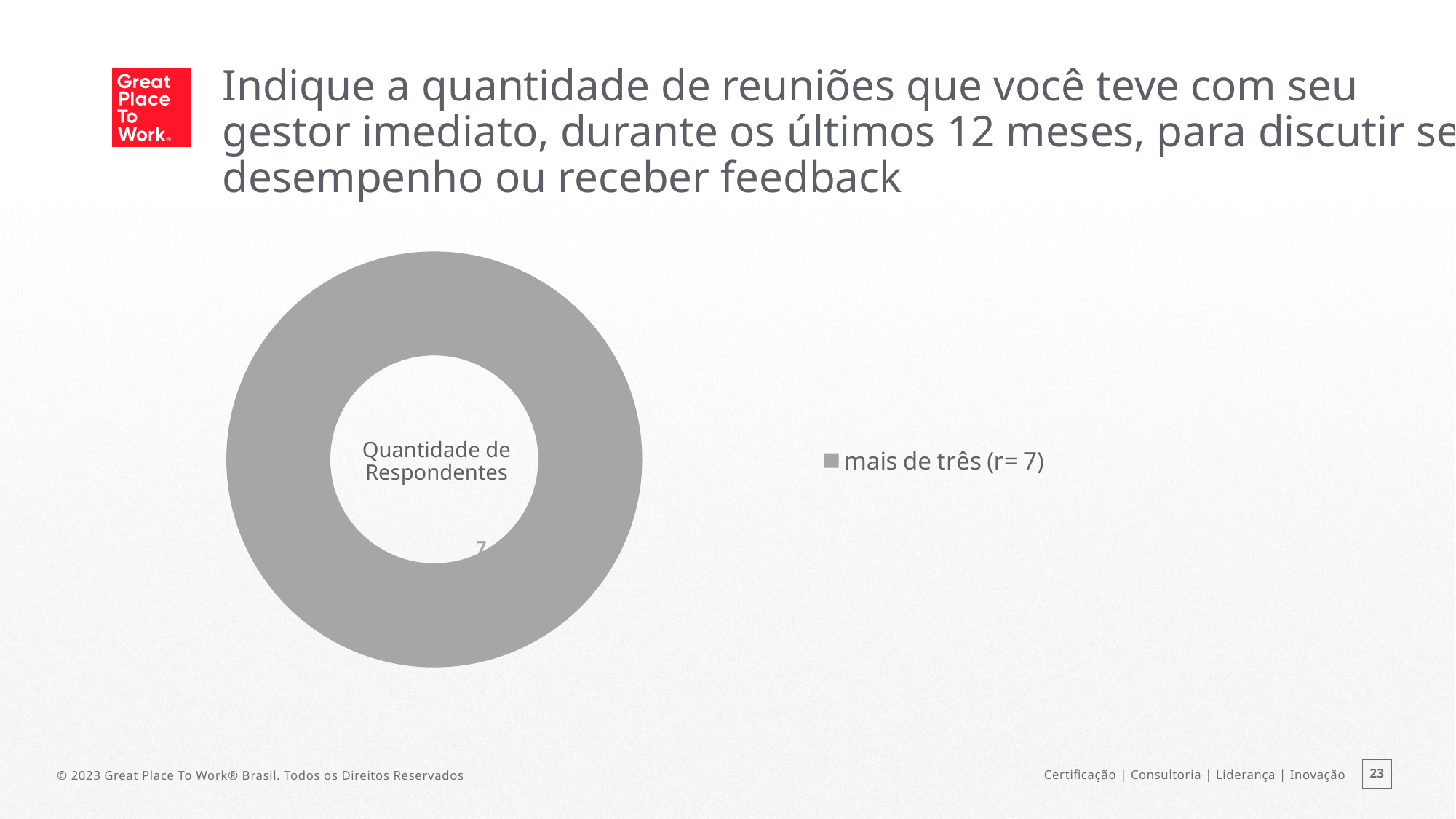
How many entries does the chart legend list? 1 What is the legend entry of the doughnut chart? mais de três (r= 7) Which category has the highest value in the doughnut chart? mais de três What kind of chart is shown on the slide? doughnut chart How many slices does the doughnut chart have? 1 What is the value shown for the slice "mais de três"? 7 What is the total of all slices in the doughnut chart? 7 Is the value for "mais de três" greater or less than 5? greater What text is shown in the centre of the doughnut chart? Quantidade de Respondentes What share of the doughnut does the slice "mais de três" represent? 100%